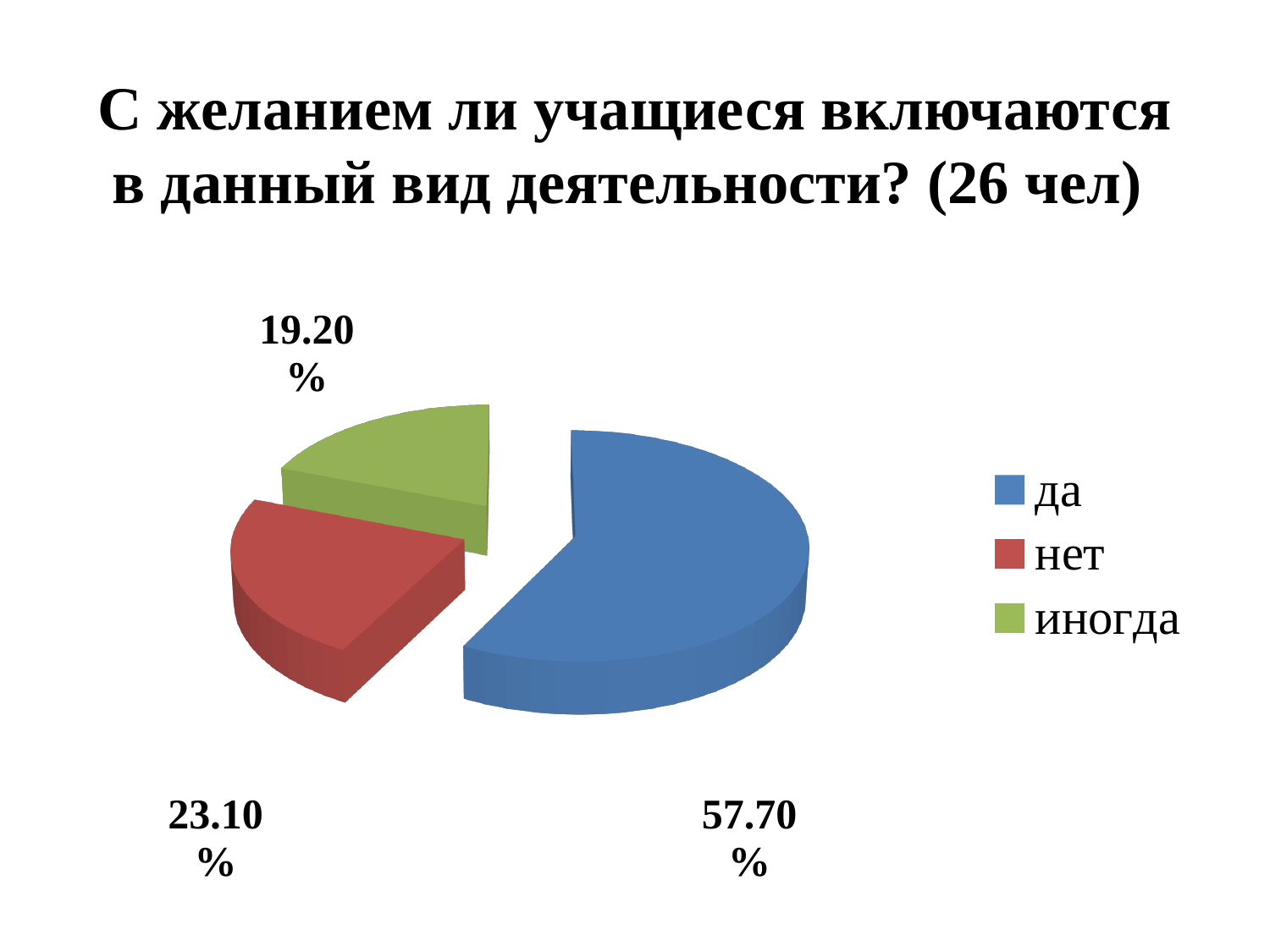
How many categories does the pie chart have? 3 What colour is the slice for "да"? blue What is the difference in percentage points between the "нет" slice and the "иногда" slice? 3.90% What is the difference in percentage points between the "да" slice and the "нет" slice? 34.60% What kind of chart is shown on the slide? pie chart What percentage of the pie is labelled for "иногда"? 19.20% Which slice is larger, "нет" or "иногда"? нет What percentage of the pie is labelled for "да"? 57.70% What percentage of the pie is labelled for "нет"? 23.10% Which category has the largest slice of the pie? да Which category has the smallest slice of the pie? иногда How many respondents does the chart title say were surveyed? 26